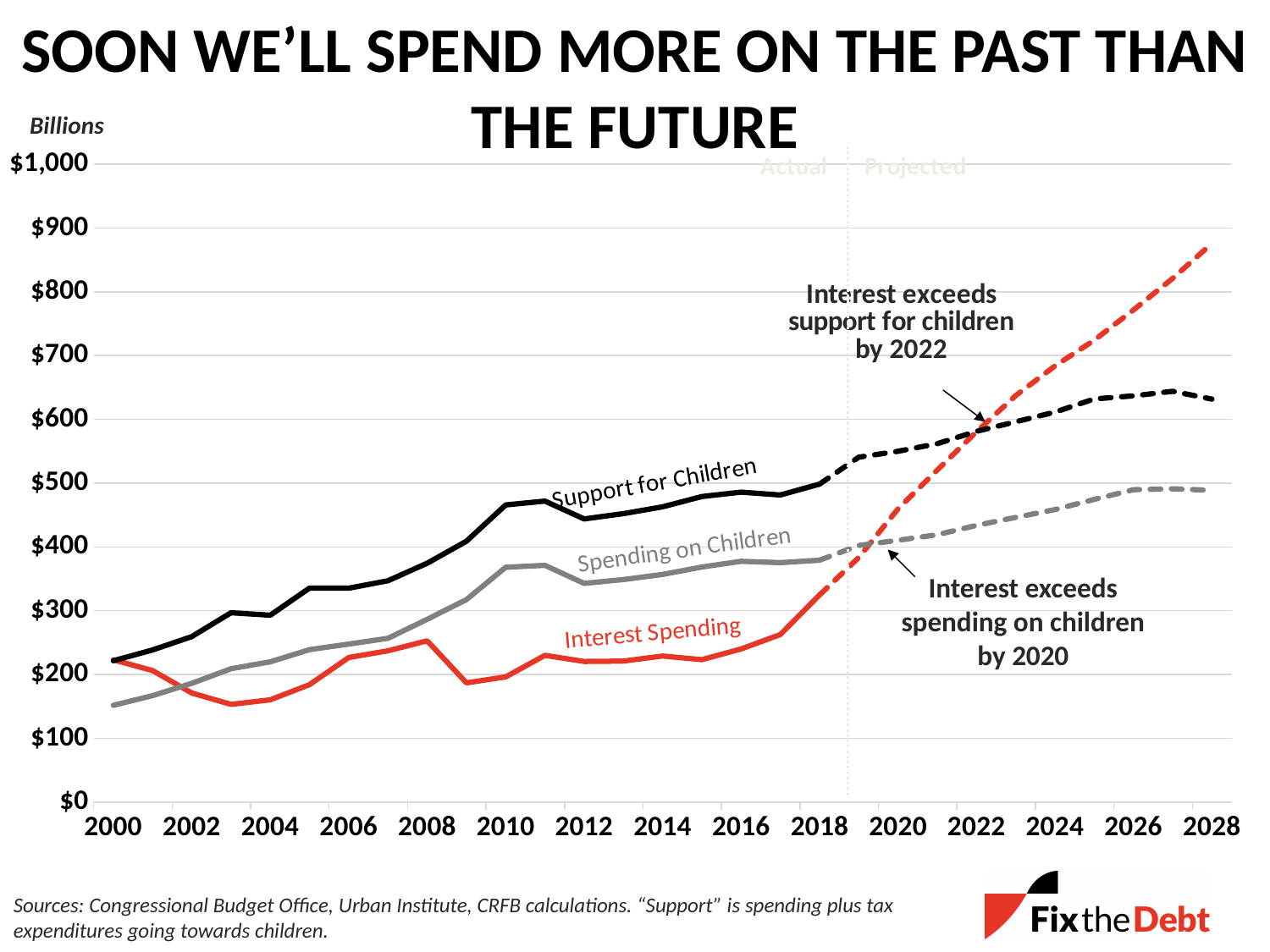
How many data series are plotted on the chart? 3 Which series has the lowest value in 2028? Spending on Children In 2010, which is larger: Spending on Children or Interest Spending? Spending on Children Which series has the highest value in 2028? Interest Spending Is the value for Interest Spending in 2018 greater or less than $300? greater What kind of chart is shown on the slide? line chart Is the value for Interest Spending in 2028 greater or less than $800? greater Does Interest Spending rise or fall between 2018 and 2028? rise Is the value for Spending on Children in 2000 greater or less than $200? less What unit is shown for the vertical axis? Billions According to the chart annotation, in what year does interest exceed spending on children? 2020